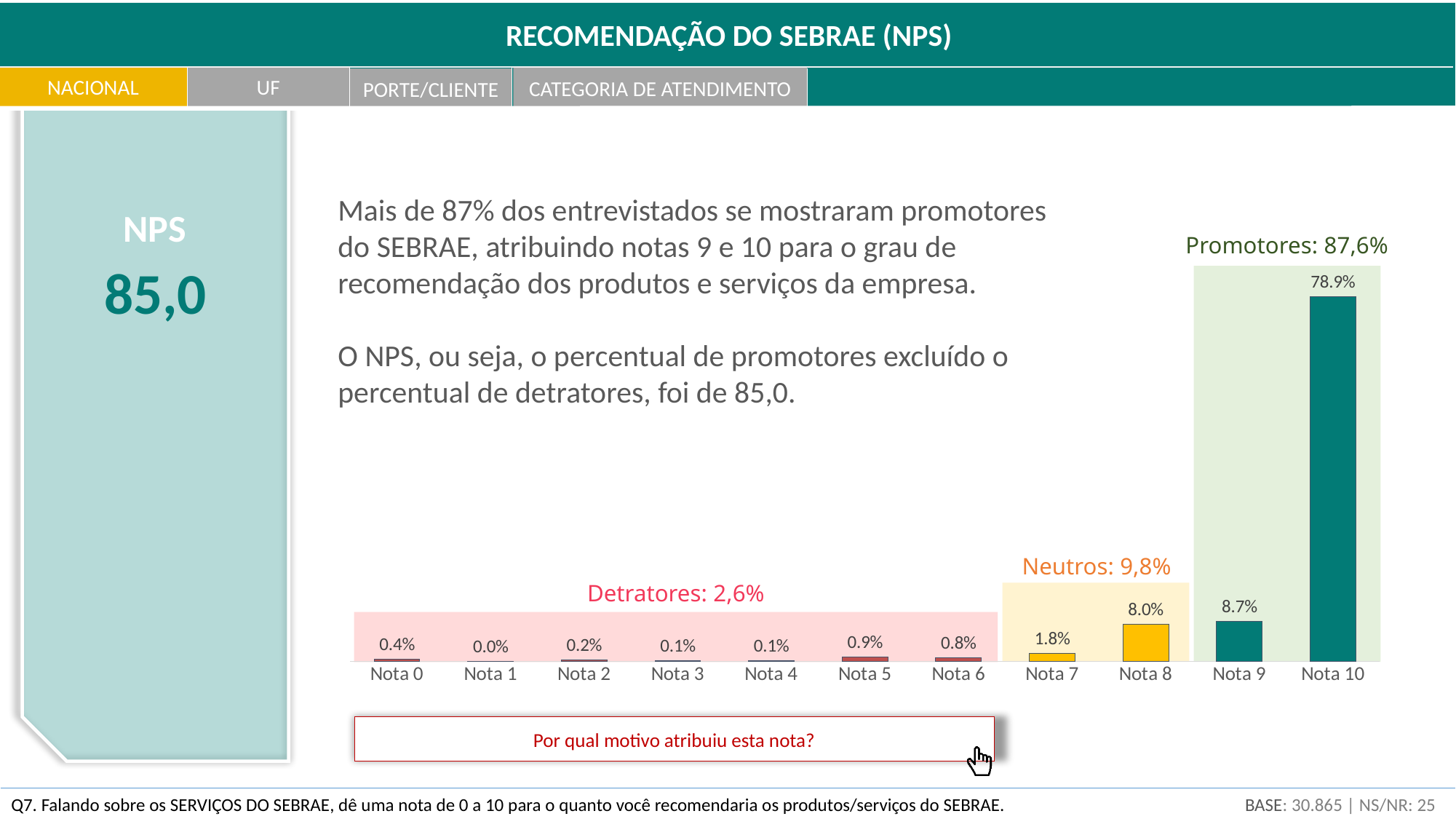
What is the value for Nota 5? 0.9% Which category has the highest value? Nota 10 What percentage is shown for the Detratores group? 2,6% Which is larger, the value for Nota 9 or the value for Nota 8? Nota 9 How many categories are shown on the x axis? 11 What is the difference between the values for Nota 8 and Nota 7? 6.2% What kind of chart is shown on the slide? Bar chart Which category has the lowest value? Nota 1 What is the value for Nota 8? 8.0% What is the difference between the values for Nota 10 and Nota 9? 70.2% What is the value for Nota 10? 78.9% What percentage is shown for the Promotores group? 87,6%